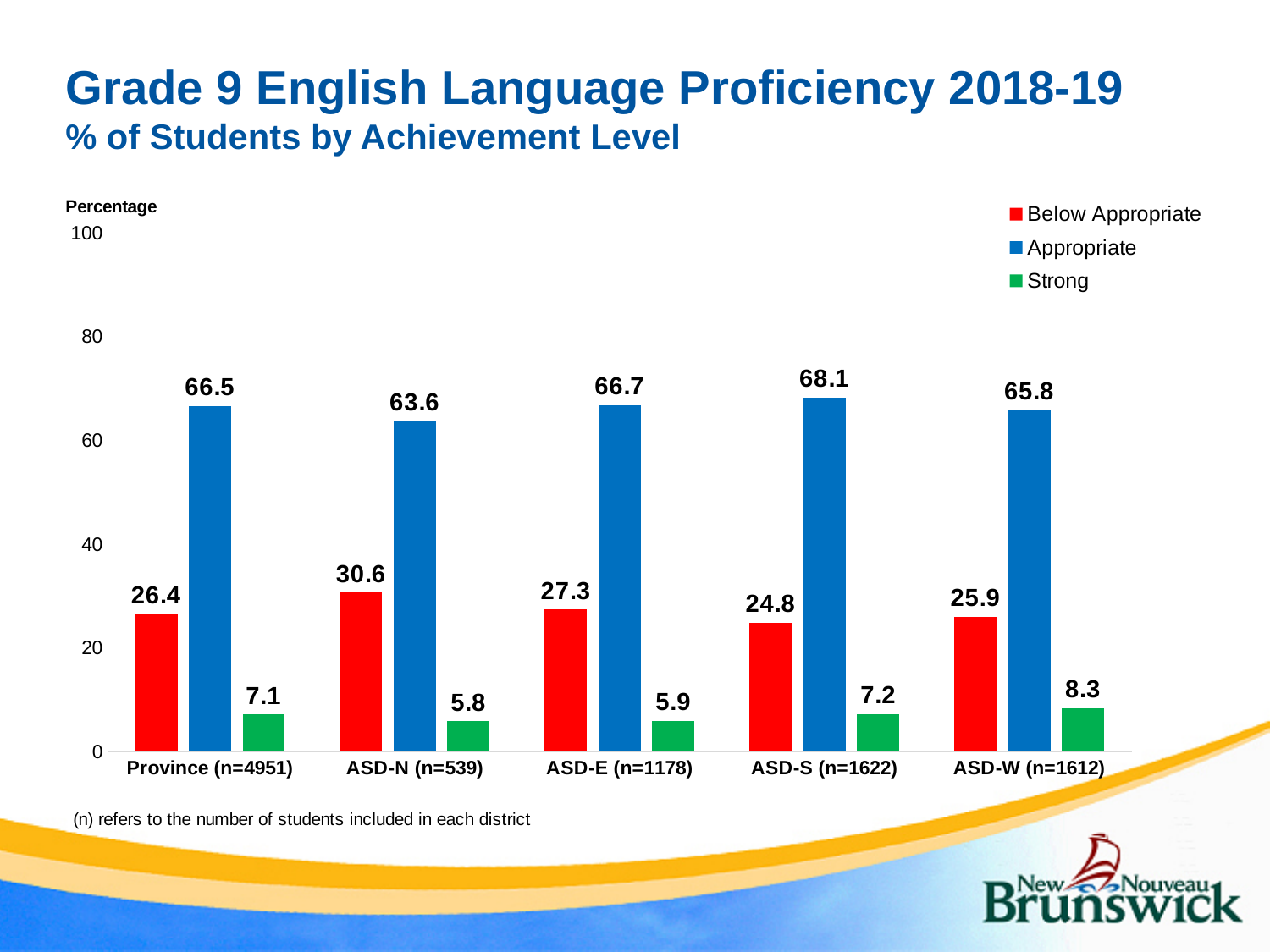
What is the difference between the Below Appropriate values for ASD-N (n=539) and ASD-S (n=1622)? 5.8 Which category has the highest Appropriate value? ASD-S (n=1622) What is the Strong value for ASD-W (n=1612)? 8.3 Is the Appropriate value for ASD-N (n=539) greater or less than 60? greater Which is larger, the Strong value for Province (n=4951) or for ASD-E (n=1178)? Province (n=4951) How many series does the legend list? 3 What kind of chart is shown on the slide? bar chart What colour represents the Strong series in the legend? green Which category has the lowest Strong value? ASD-N (n=539) What is the Below Appropriate value for ASD-N (n=539)? 30.6 How many categories are shown on the x axis? 5 What is the Appropriate value for ASD-S (n=1622)? 68.1